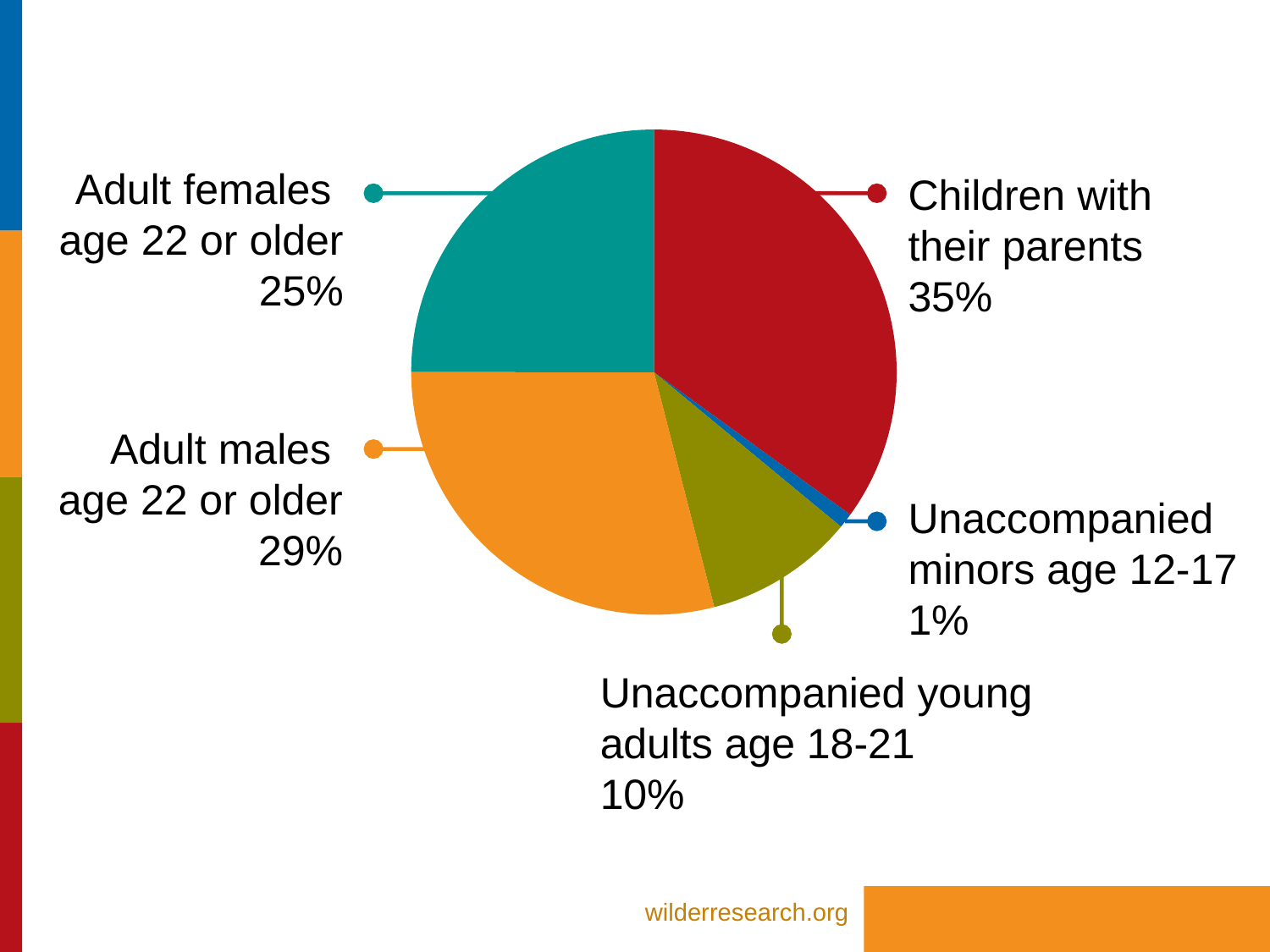
What is the difference in percentage points between Children with their parents and Adult females age 22 or older? 10 Which category has the largest share of the pie? Children with their parents What share of the pie is Adult males age 22 or older? 29% What share of the pie is Unaccompanied young adults age 18-21? 10% What share of the pie is Adult females age 22 or older? 25% What colour is the slice for Adult females age 22 or older? Teal How many categories does the pie chart show? 5 Which is larger: the share for Adult males age 22 or older or the share for Adult females age 22 or older? Adult males age 22 or older Which category has the smallest share of the pie? Unaccompanied minors age 12-17 What share of the pie is Unaccompanied minors age 12-17? 1% What kind of chart is shown on the slide? Pie chart What share of the pie is Children with their parents? 35%